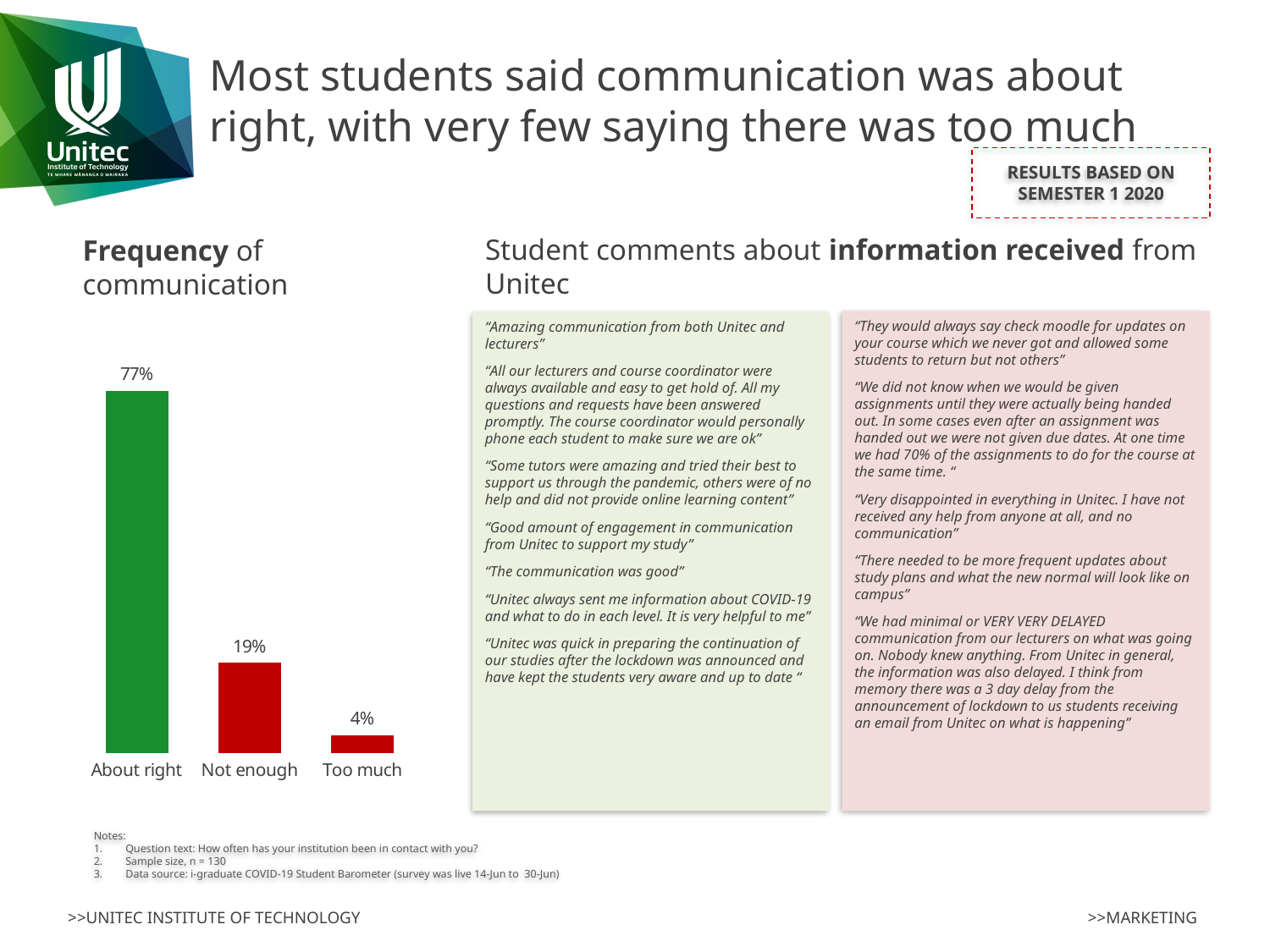
Which category has the lowest value in the frequency of communication chart? Too much Do the values rise or fall moving from left to right across the categories in the chart? Fall How many categories are shown in the frequency of communication chart? 3 What percentage of students said the frequency of communication was 'Not enough'? 19% What percentage of students said the frequency of communication was 'Too much'? 4% What is the difference between the 'Not enough' and 'Too much' percentages? 15% What is the difference between the 'About right' and 'Not enough' percentages? 58% What type of chart is used to show the frequency of communication? Bar chart What colour is the 'About right' bar in the chart? Green Which category has the highest value in the frequency of communication chart? About right Which is larger, the value for 'Not enough' or the value for 'Too much'? Not enough What percentage of students said the frequency of communication was 'About right'? 77%